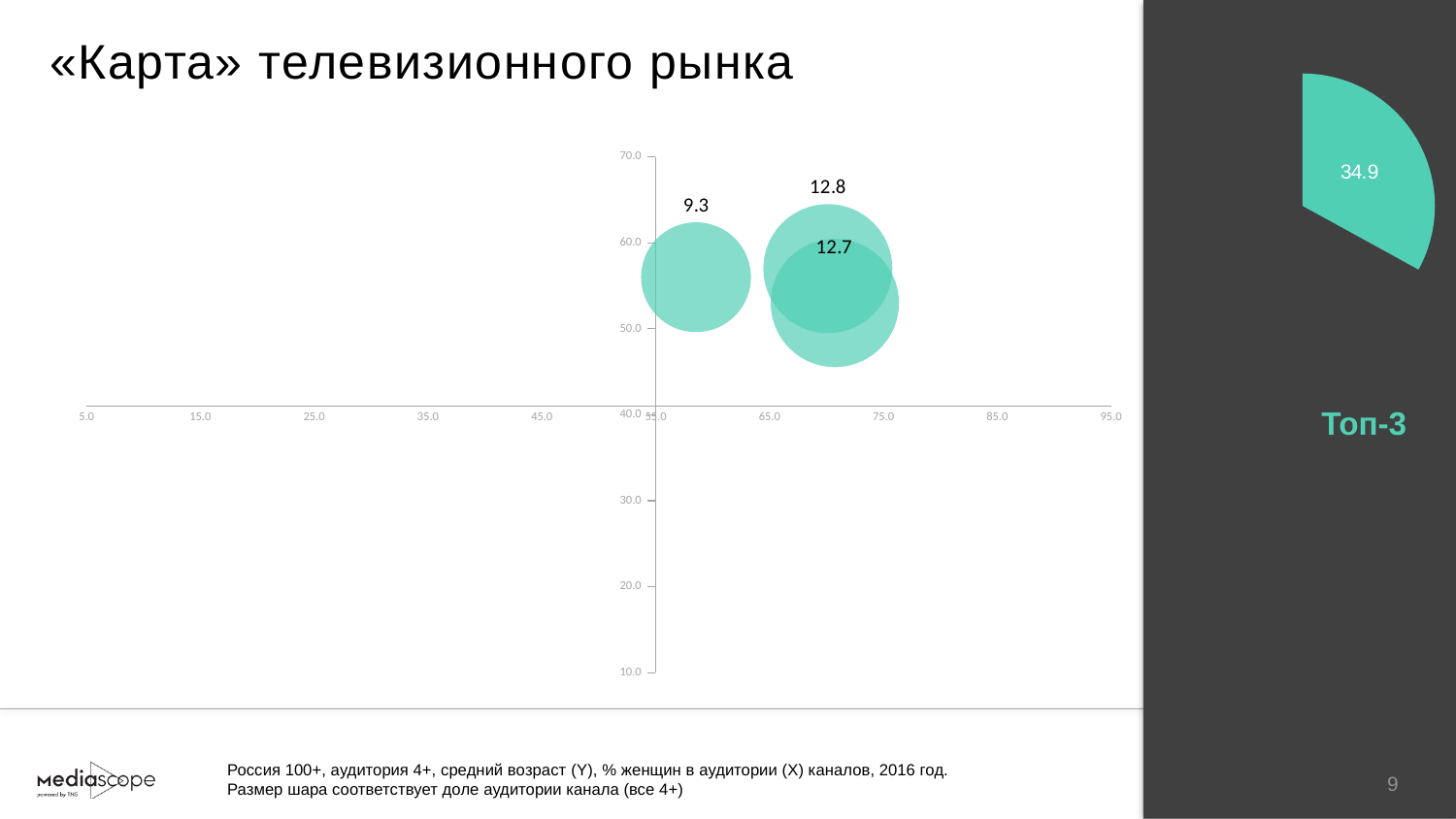
How many bubbles are plotted on the chart? 3 What is the title of the chart slide? «Карта» телевизионного рынка Is the Y-axis value of the bubble labelled 12.7 greater or less than 40.0? greater Is the Y-axis value (average age) of the bubble labelled 9.3 greater or less than 50.0? greater What is the smallest bubble value labelled on the chart? 9.3 Which bubble label is larger, 12.8 or 12.7? 12.8 What is the difference between the largest bubble label (12.8) and the smallest bubble label (9.3)? 3.5 What is the largest bubble value labelled on the chart? 12.8 Is the X-axis value of the bubble labelled 9.3 greater or less than 65.0? less What kind of chart is shown on the slide? bubble chart What value is shown in the Топ-3 graphic on the right side of the slide? 34.9